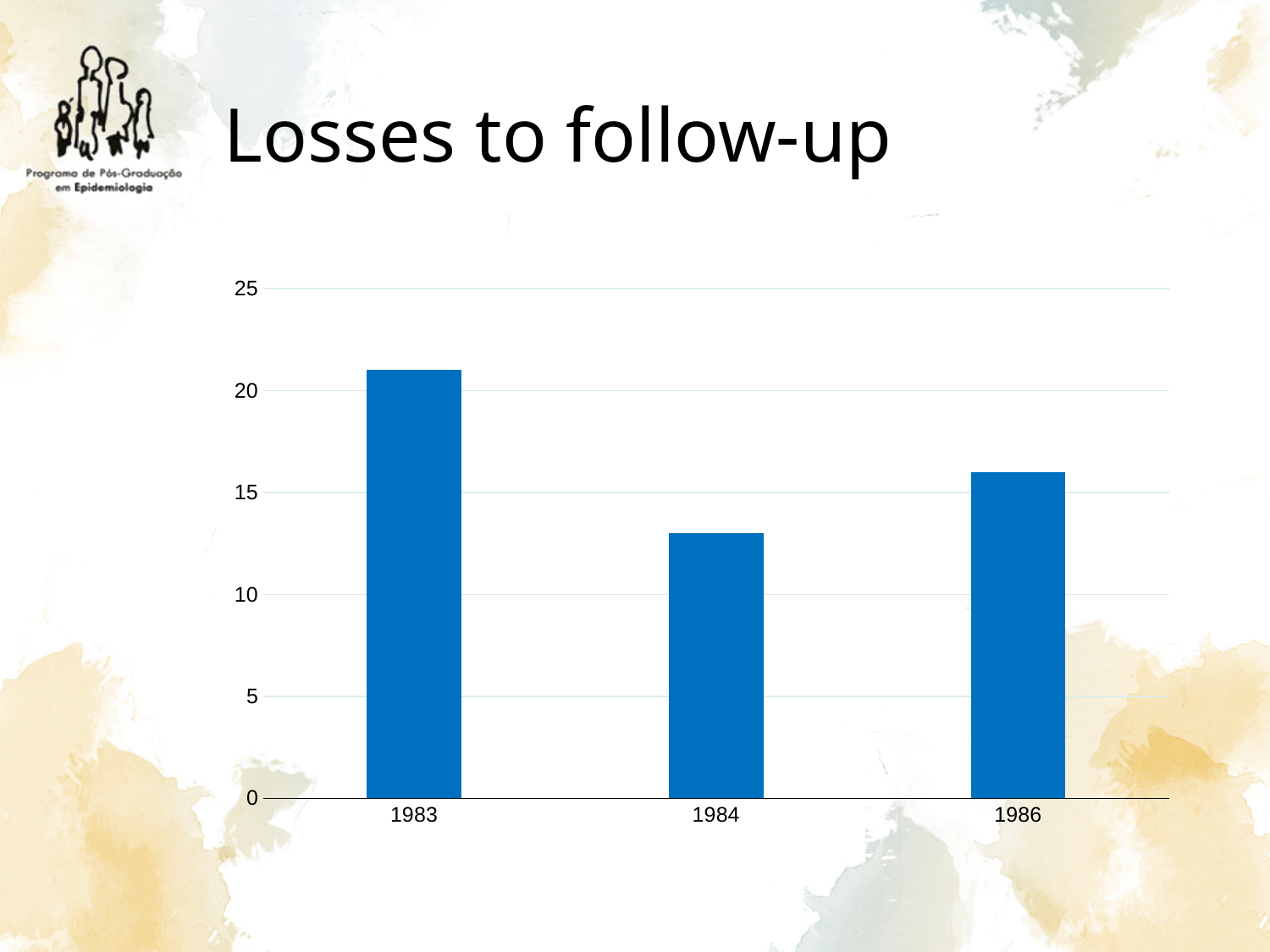
Is the value for 1984 greater or less than 10? greater Is the value for 1986 greater or less than 20? less What kind of chart is shown on the slide? bar chart Which year has the highest value in the chart? 1983 Do the values rise or fall from 1983 to 1984? fall Is the value for 1983 greater or less than 15? greater Which is larger, the value for 1983 or the value for 1984? 1983 How many years are shown on the x axis of the chart? 3 Which year has the lowest value in the chart? 1984 What is the title of the chart? Losses to follow-up Which is larger, the value for 1986 or the value for 1984? 1986